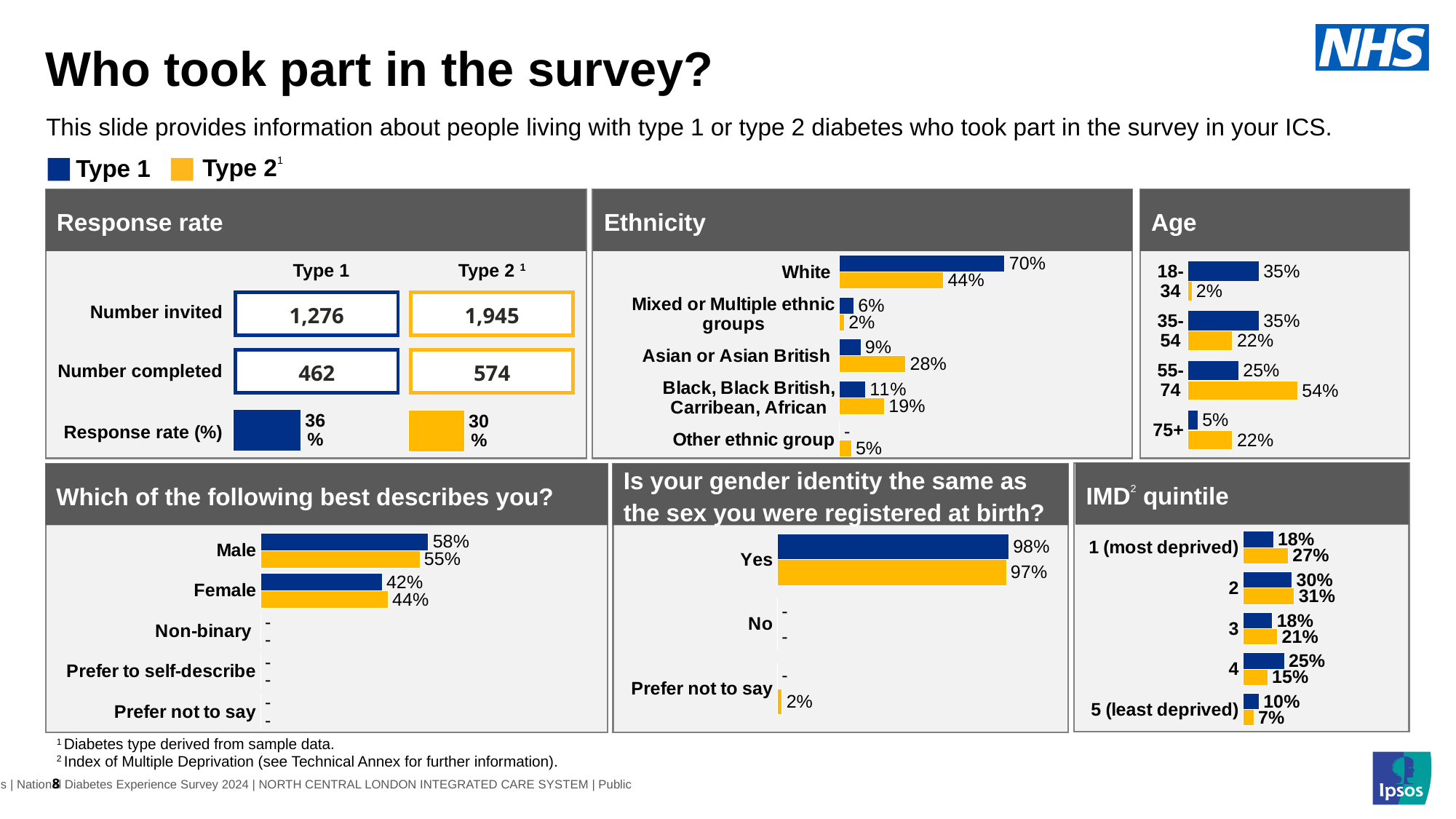
In the IMD quintile chart, what is the Type 1 value for quintile 4? 25% In the 'Which of the following best describes you?' chart, what is the Type 2 value for Female? 44% In the Ethnicity chart, what is the Type 1 value for White? 70% In the 'Which of the following best describes you?' chart, which is larger for Type 1: Male or Female? Male In the Response rate chart, how many people with Type 2 were invited? 1,945 In the Age chart, which age group has the highest Type 2 value? 55-74 In the gender identity chart, what is the Type 2 value for Yes? 97% In the IMD quintile chart, which quintile has the lowest Type 2 value? 5 (least deprived) In the Ethnicity chart, what is the Type 2 value for Asian or Asian British? 28% In the Response rate chart, what is the response rate (%) for Type 1? 36% In the Age chart, what is the difference between the Type 2 and Type 1 values for 75+? 17% How many series does the legend at the top of the slide list? 2